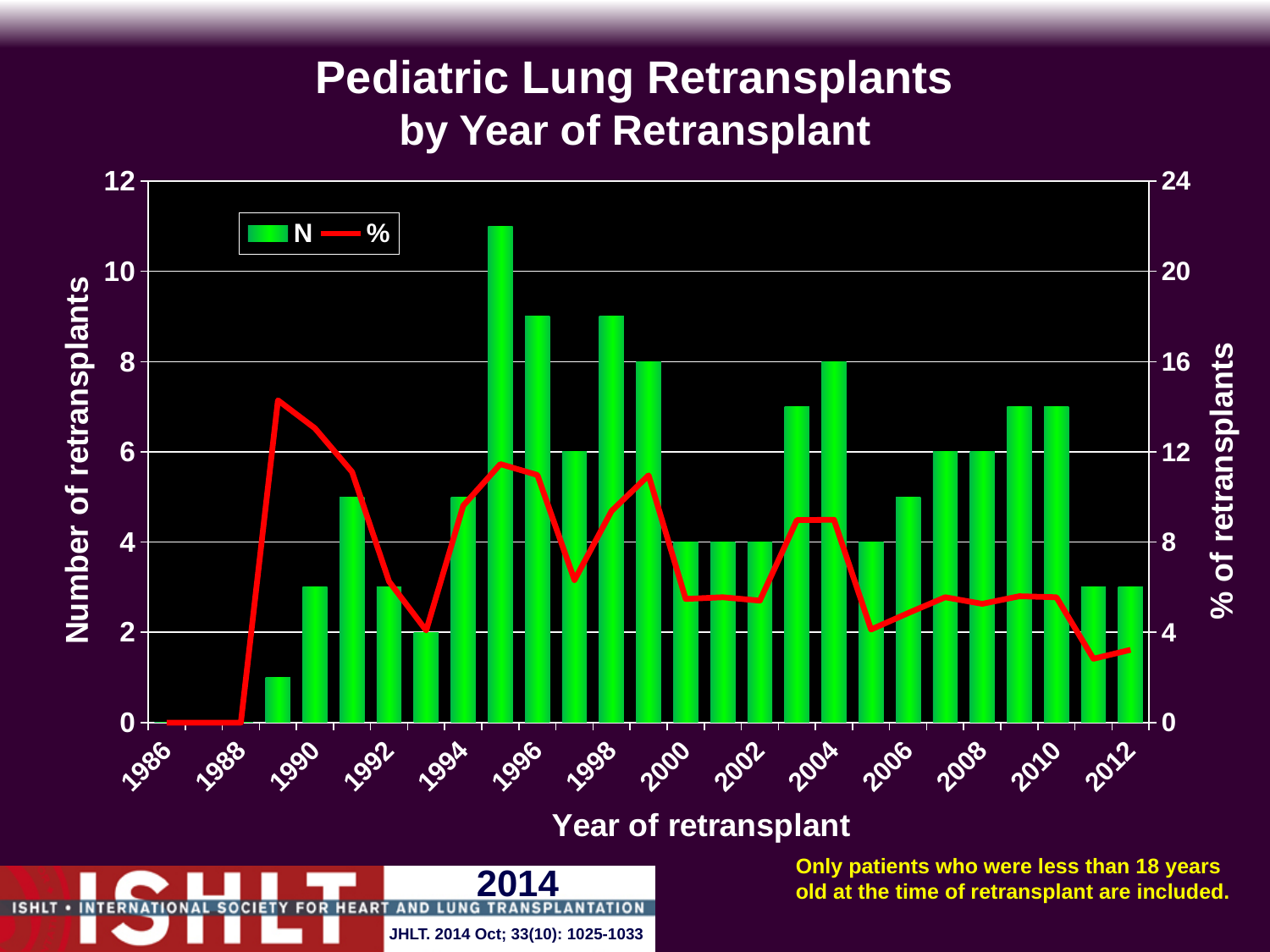
Is the number of retransplants for 2012 greater or less than 4? less What type of chart is shown on the slide? bar chart with a line Does the % line rise or fall between 2010 and 2012? fall Which year has more retransplants, 2004 or 2002? 2004 What is the difference in number of retransplants between 2004 and 2000? 4 Is the number of retransplants for 2010 greater or less than 6? greater What is the number of retransplants (N) for 2008? 6 How many series does the legend list? 2 What is the number of retransplants (N) for 2004? 8 What is the title of the right-hand vertical axis? % of retransplants Is the number of retransplants for 1996 greater or less than 8? greater What is the number of retransplants (N) for 2000? 4